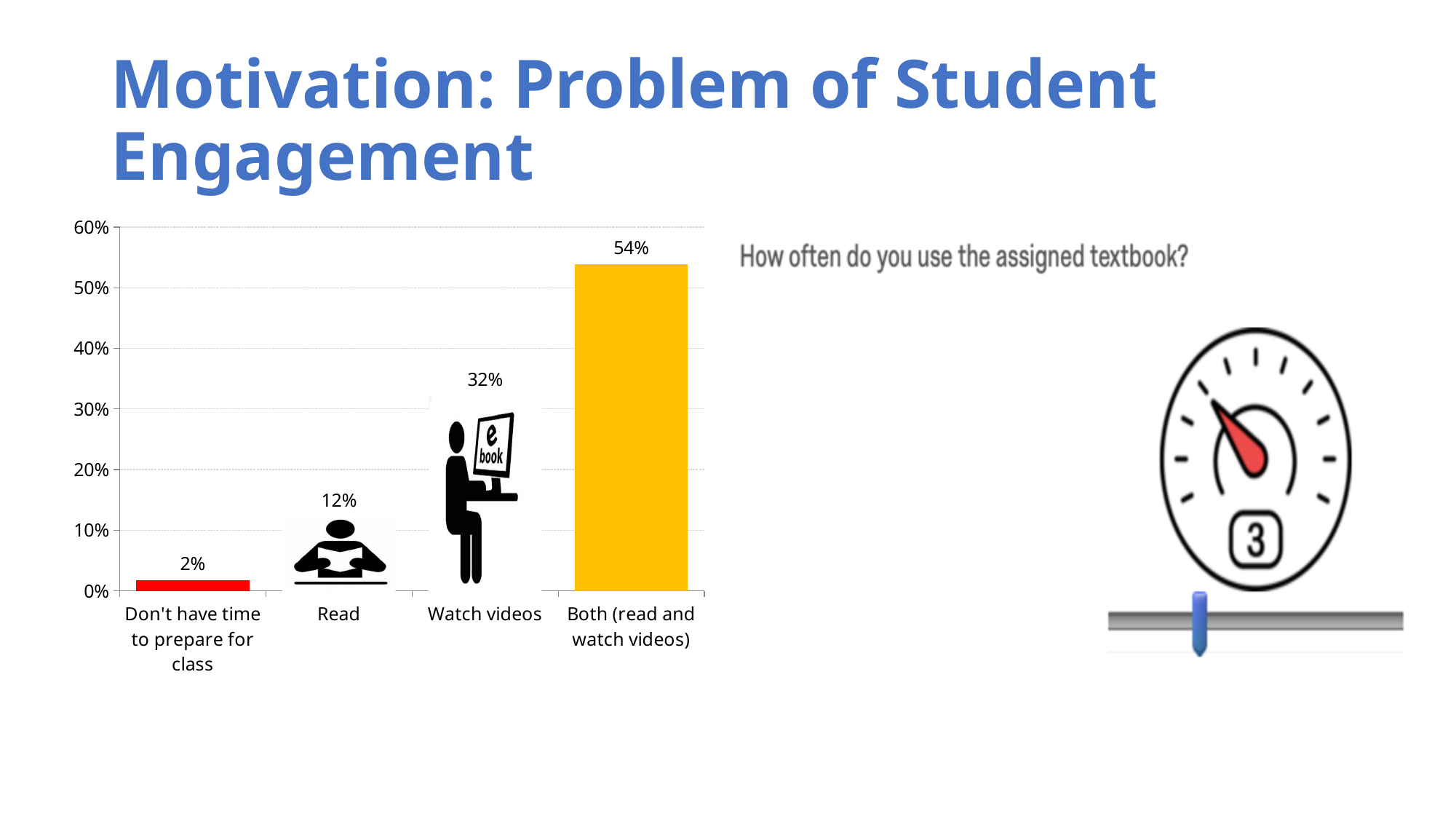
Which category has the lowest value in the bar chart? Don't have time to prepare for class Which category has the highest value in the bar chart? Both (read and watch videos) What is the value for "Read" in the bar chart? 12% Do the values in the bar chart rise or fall from left to right along the x axis? Rise What is the difference between the values for "Both (read and watch videos)" and "Watch videos"? 22% What kind of chart is shown on the left of the slide? Bar chart What is the value for "Don't have time to prepare for class" in the bar chart? 2% Which is larger, the value for "Read" or the value for "Watch videos"? Watch videos How many categories are shown in the bar chart? 4 What is the difference between the values for "Read" and "Don't have time to prepare for class"? 10% What is the value for "Watch videos" in the bar chart? 32% What is the value for "Both (read and watch videos)" in the bar chart? 54%